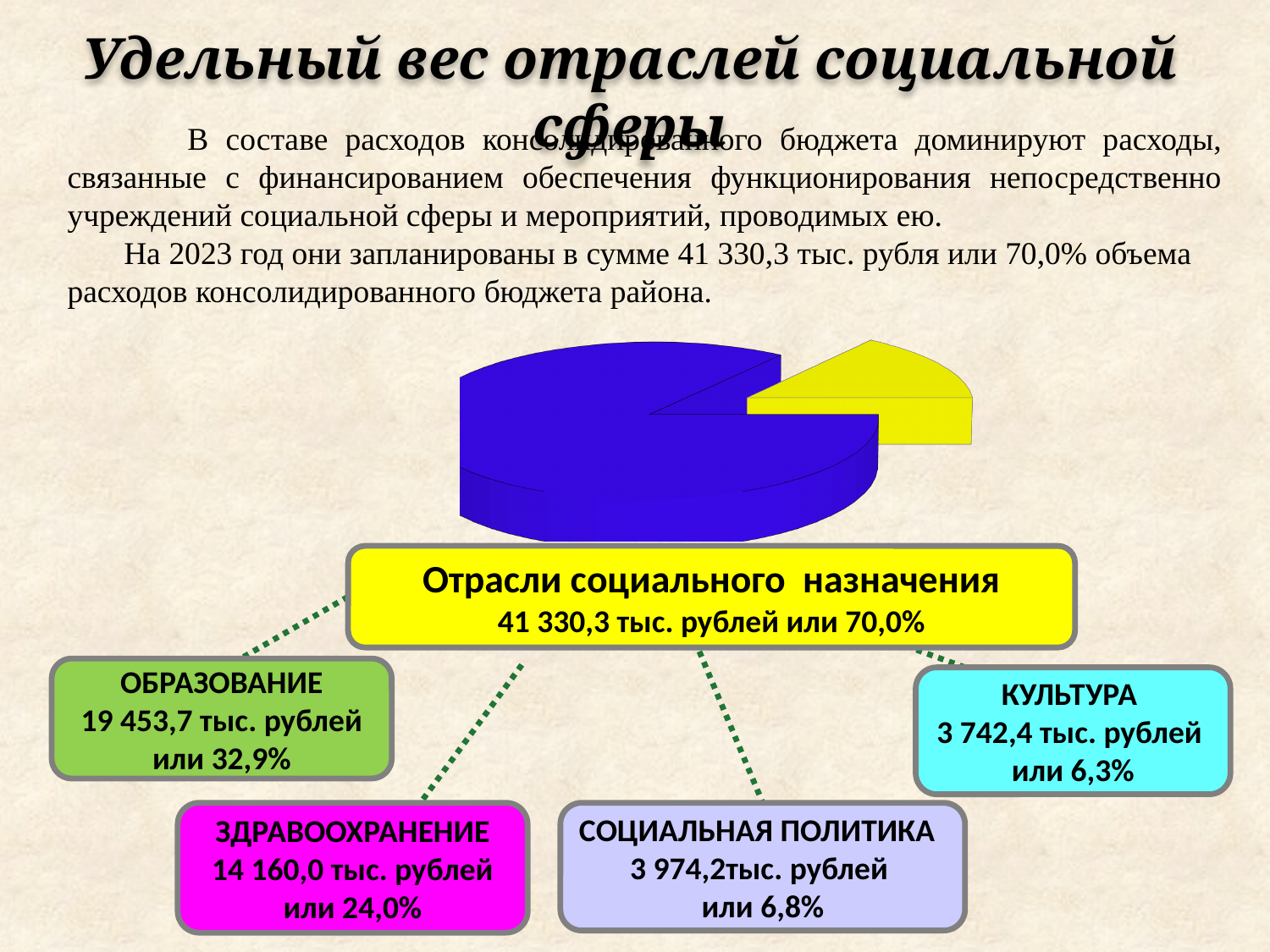
What kind of chart is shown on the slide? pie chart Is the pie chart drawn in 3D or flat 2D? 3D Does the yellow slice of the pie chart take up more or less than half of the pie? less Does the blue slice of the pie chart take up more or less than half of the pie? more Which slice of the pie chart is the largest? the blue slice How many slices does the pie chart have? 2 Which slice of the pie chart is the smallest? the yellow slice Which is larger in the pie chart, the blue slice or the yellow slice? the blue slice What two colours are used for the slices of the pie chart? blue and yellow According to the slide text, what share of the consolidated budget expenditures do the social sphere sectors (the large slice) represent? 70,0%